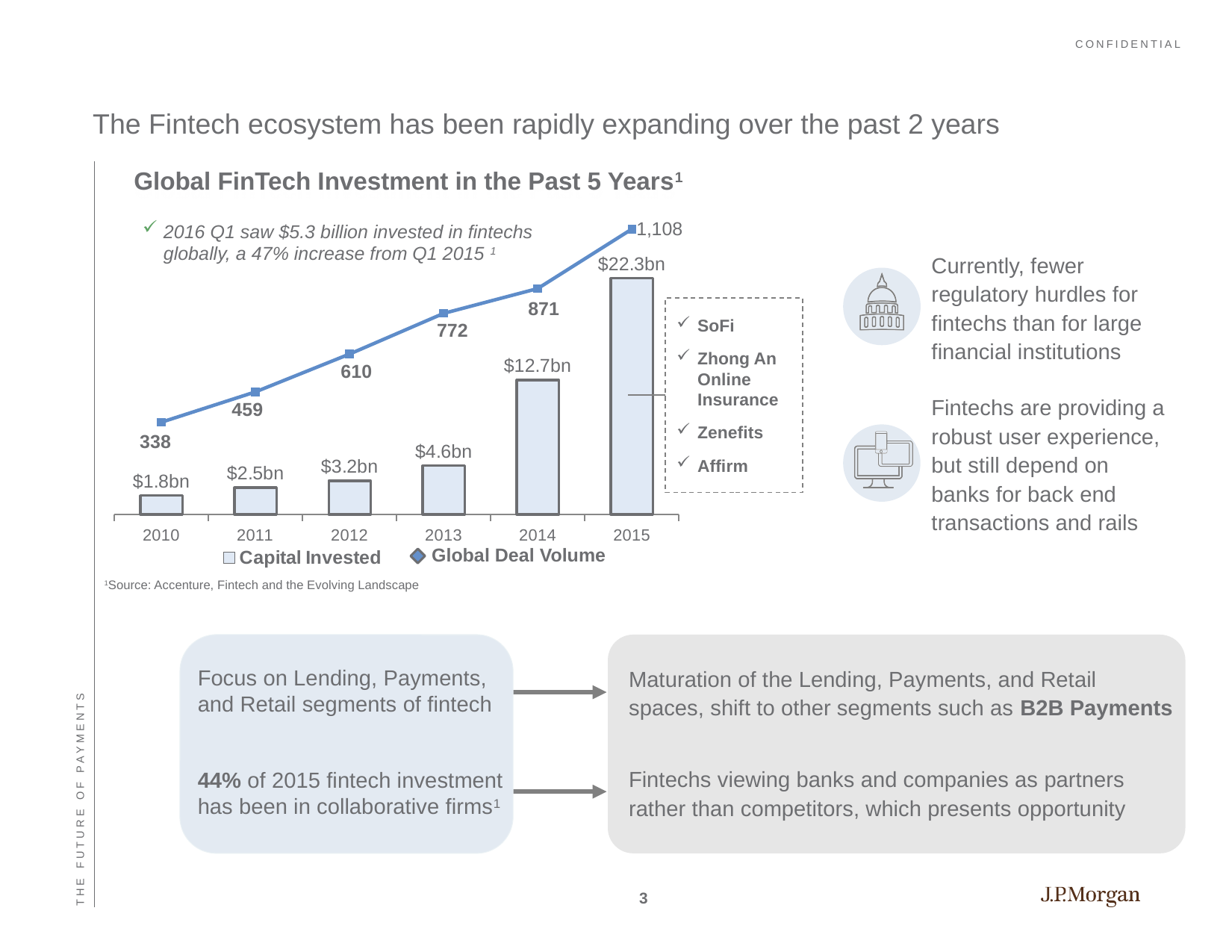
What was the Capital Invested in 2014? $12.7bn Does Global Deal Volume rise or fall from 2010 to 2015? Rise What was the Capital Invested in 2010? $1.8bn Which year had the highest Capital Invested? 2015 Which year had the lowest Global Deal Volume? 2010 Which year had higher Capital Invested, 2013 or 2014? 2014 What kind of chart is used to show Capital Invested? Bar chart What was the Global Deal Volume in 2012? 610 How many series does the legend list? 2 What is the title of the chart? Global FinTech Investment in the Past 5 Years How many years are shown on the x axis? 6 What is the difference in Global Deal Volume between 2015 and 2014? 237